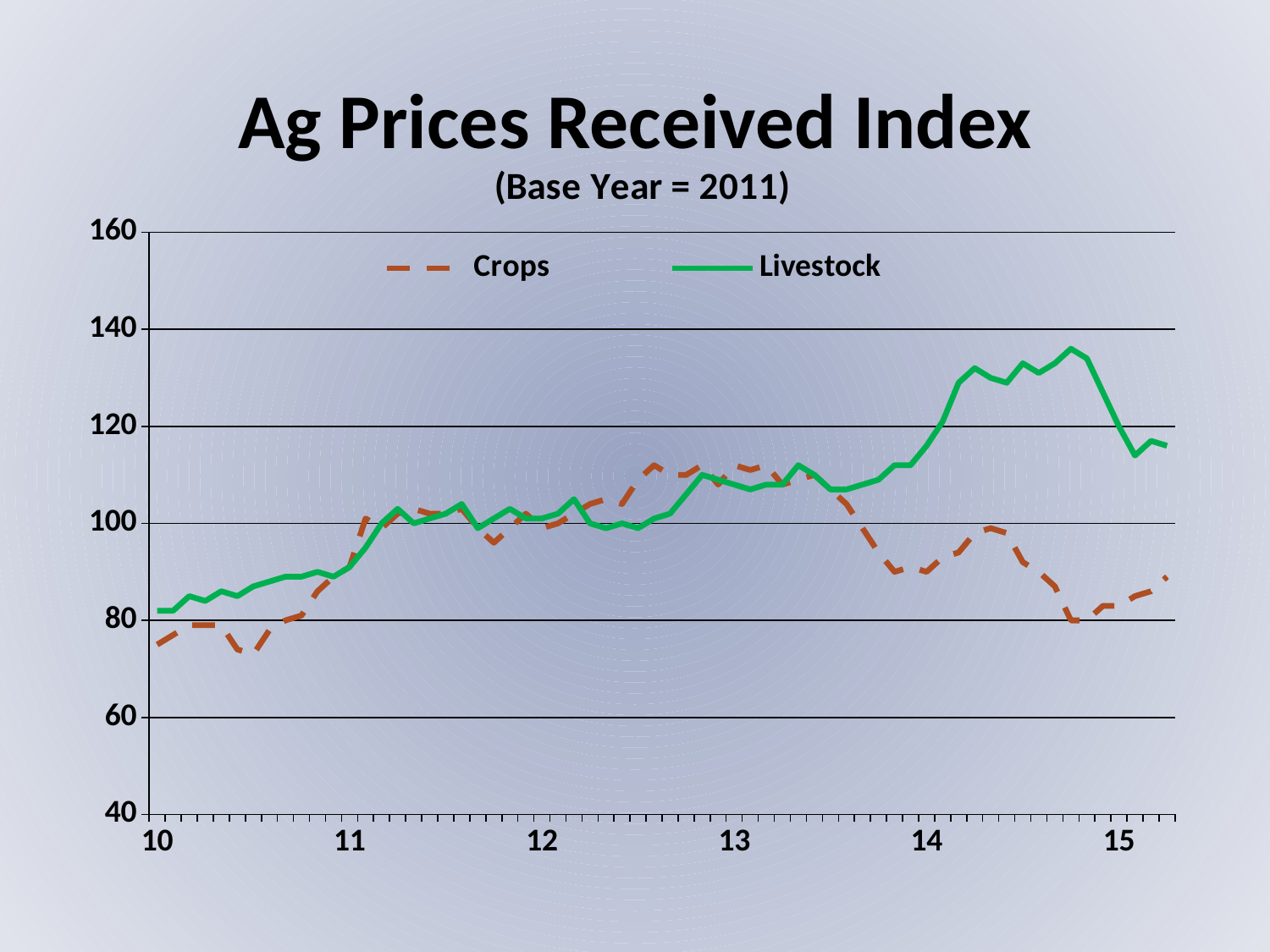
What kind of chart is shown on the slide? line chart How many series does the legend list? 2 Which series is drawn with a dashed line? Crops At year 14.5, which series has the larger value, Crops or Livestock? Livestock Does the Livestock series rise or fall between year 14 and year 14.75? rise Which series has the lowest value anywhere on the chart? Crops Which series reaches the highest value anywhere on the chart? Livestock Is the value for Crops at the start of the chart (year 10) greater or less than 80? less Is the value for Livestock at its peak between 14 and 15 greater or less than 120? greater What is the title of the chart? Ag Prices Received Index Is the value for Livestock at year 10 greater or less than 100? less Does the Crops series rise or fall between year 13.5 and year 14.75? fall